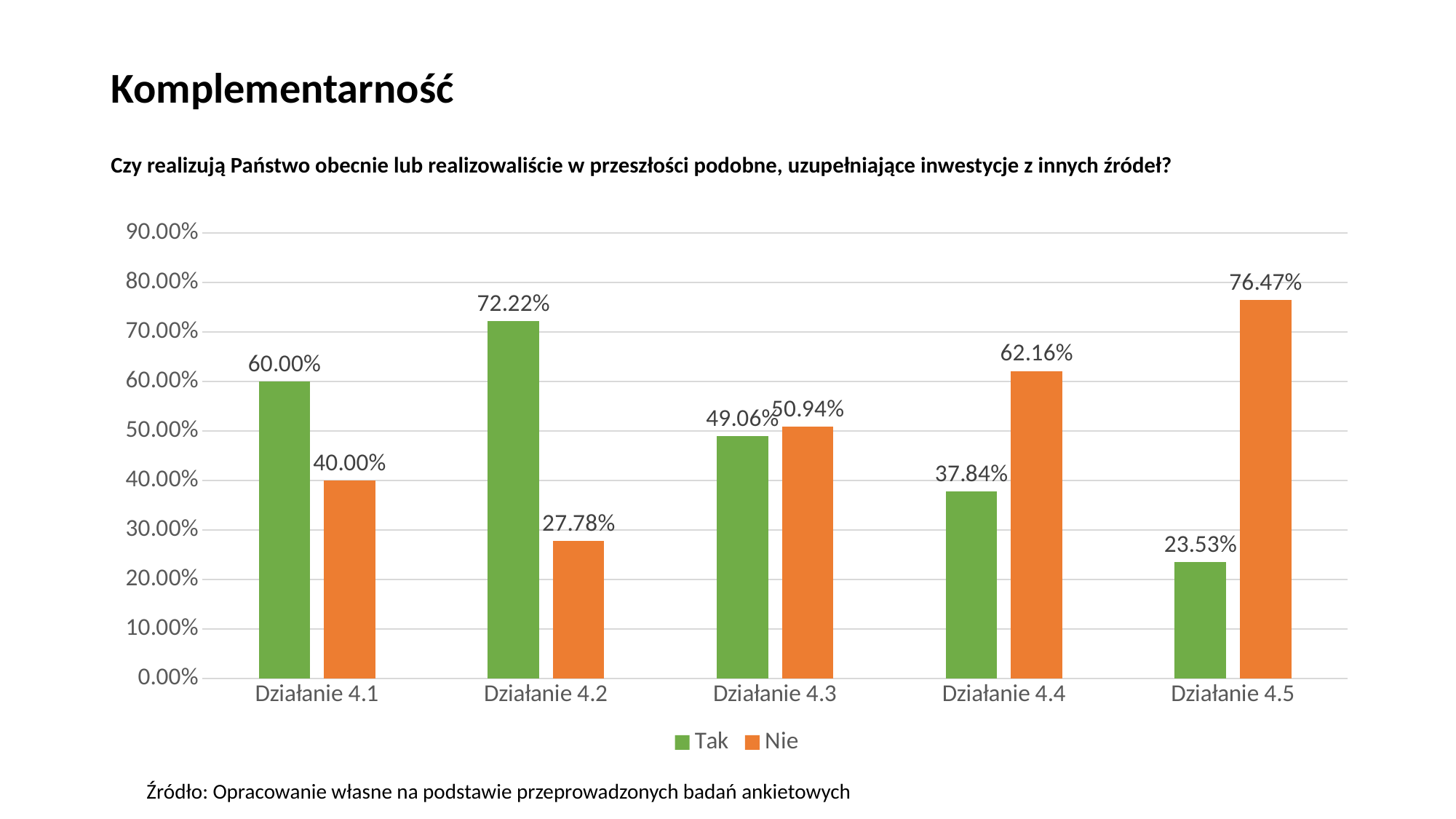
Is the Tak value for Działanie 4.5 greater or less than 30.00%? less Which colour represents the Nie series? orange Which category has the highest Tak value? Działanie 4.2 What is the value for Nie for Działanie 4.5? 76.47% How many categories are shown on the x axis? 5 For Działanie 4.4, which is larger, Tak or Nie? Nie What is the value for Tak for Działanie 4.4? 37.84% How many series does the legend list? 2 Which category has the lowest Nie value? Działanie 4.2 What is the value for Tak for Działanie 4.2? 72.22% What kind of chart is shown on the slide? bar chart What is the difference between the Nie and Tak values for Działanie 4.1? 20.00%